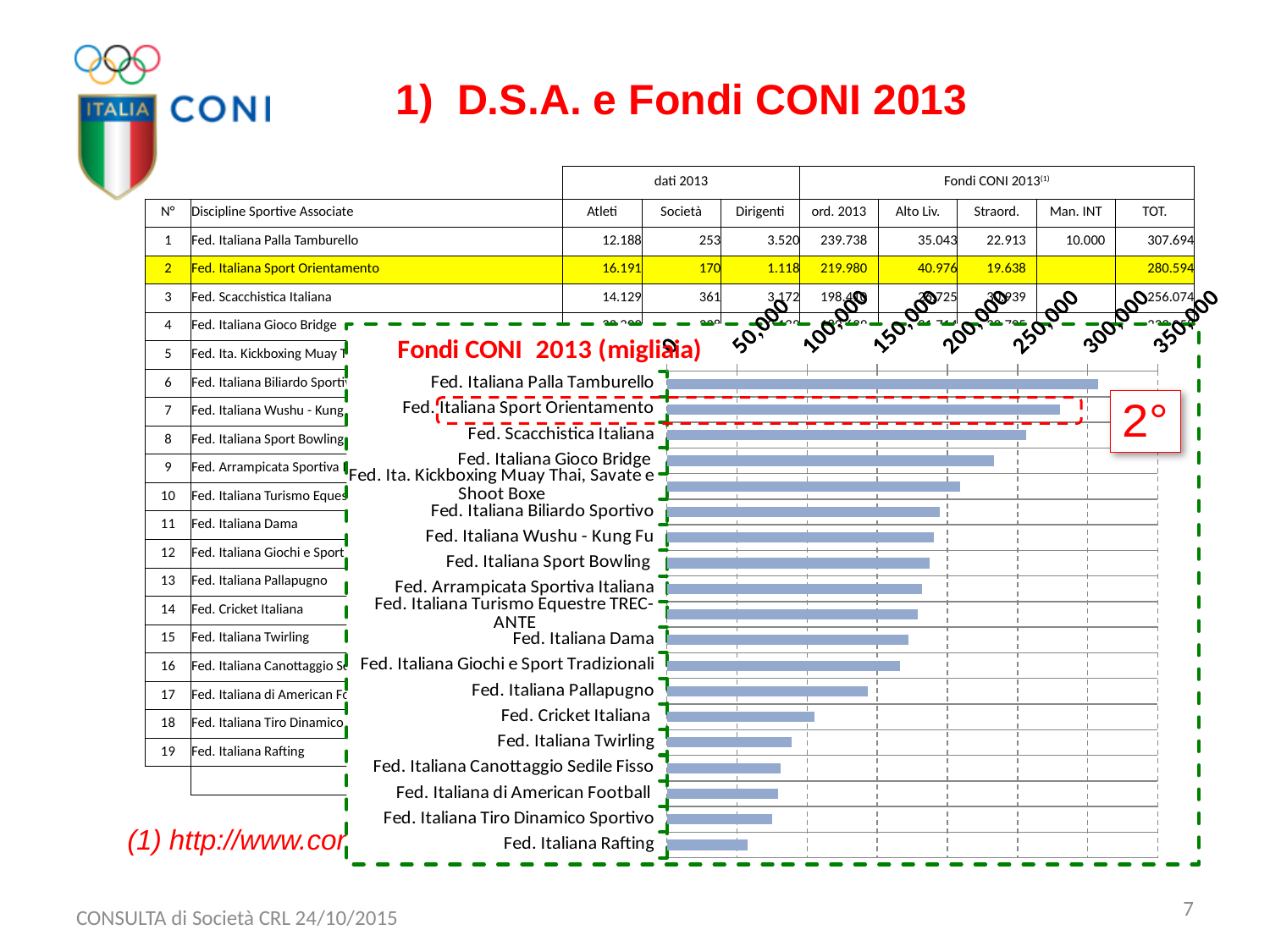
How many federations are plotted in the chart? 19 Which federation has the lowest value in the chart? Fed. Italiana Rafting Is the value for Fed. Italiana Gioco Bridge greater or less than 250,000? less Is the value for Fed. Italiana Tiro Dinamico Sportivo greater or less than 100,000? less What kind of chart is shown on the slide? bar chart Is the value for Fed. Italiana Sport Orientamento greater or less than 300,000? less Which has the larger value, Fed. Italiana Dama or Fed. Italiana Pallapugno? Fed. Italiana Dama Do the bar values increase or decrease going from the top of the chart to the bottom? decrease What is the title of the chart? Fondi CONI 2013 (migliaia) Which federation has the highest value in the chart? Fed. Italiana Palla Tamburello